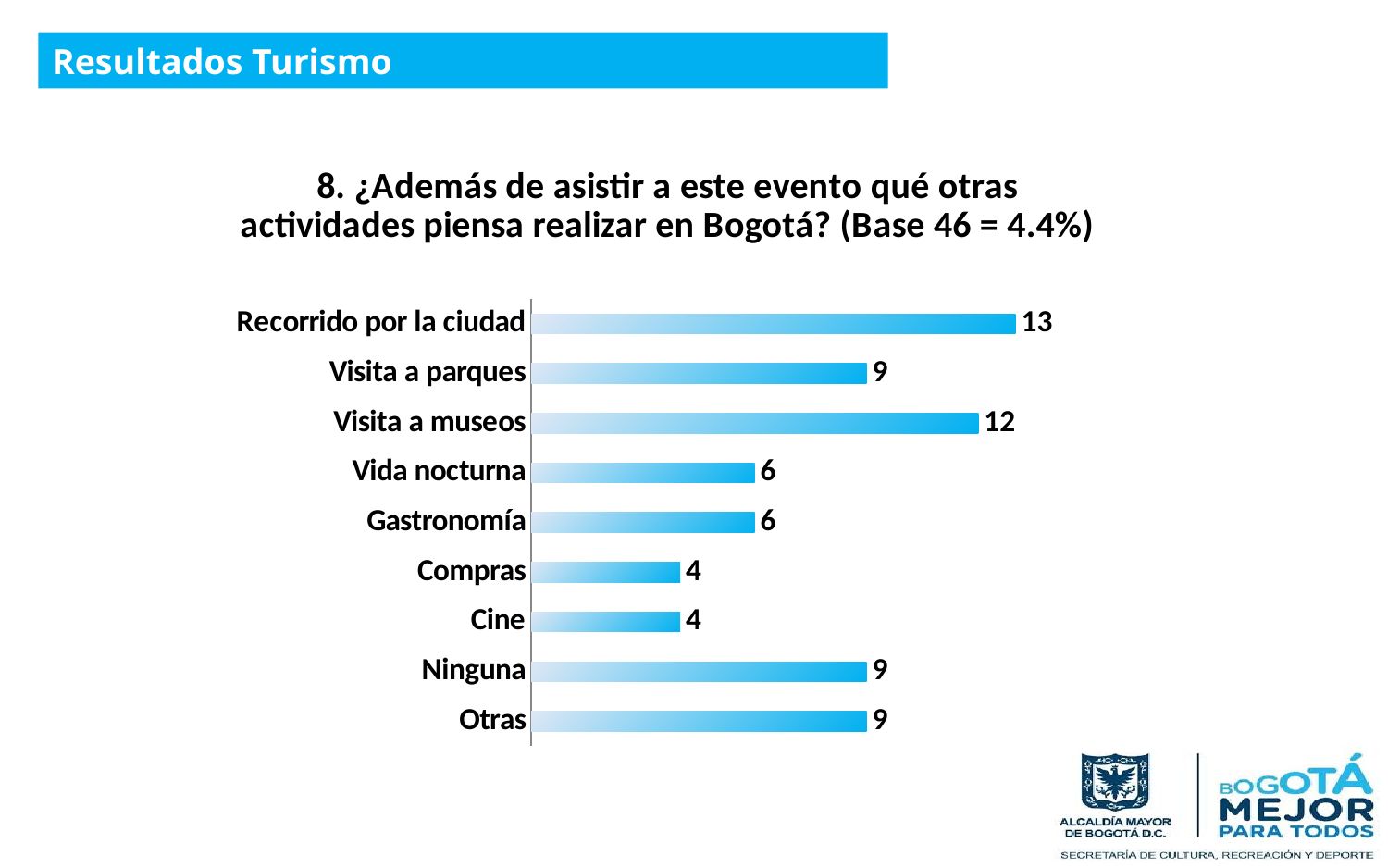
How many categories are shown in the chart? 9 What is the value for Ninguna? 9 What is the difference between Visita a parques and Cine? 5 What is the base stated in the chart title? 46 = 4.4% Which is larger, Visita a museos or Visita a parques? Visita a museos What kind of chart is shown on the slide? Bar chart Which category has the highest value? Recorrido por la ciudad Which is larger, Vida nocturna or Compras? Vida nocturna What is the value for Recorrido por la ciudad? 13 What is the value for Visita a museos? 12 What is the value for Compras? 4 What is the difference between Recorrido por la ciudad and Visita a museos? 1